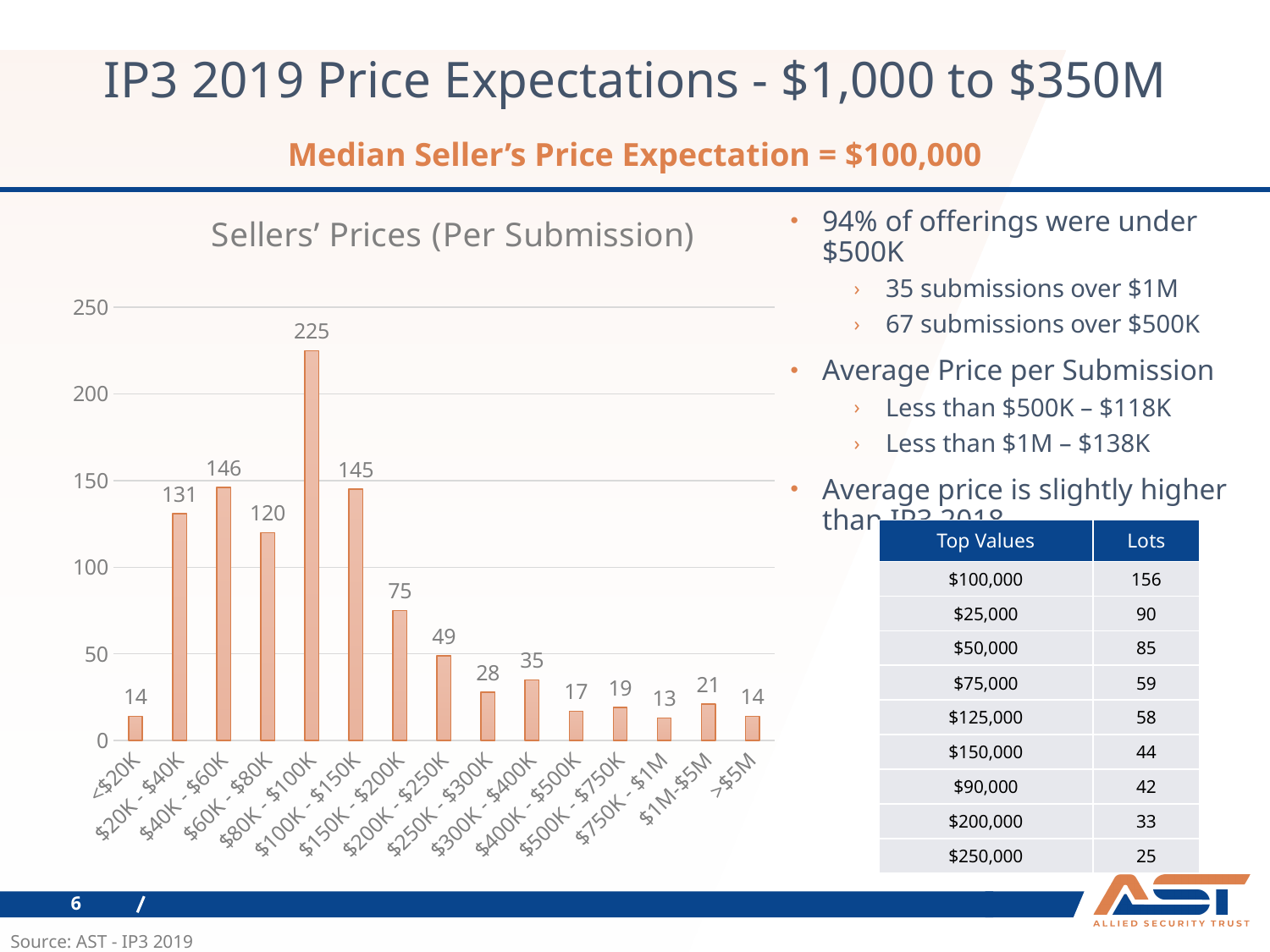
Which category has the lowest value in the Sellers' Prices (Per Submission) chart? $750K - $1M What is the difference between the values for $80K - $100K and $60K - $80K in the Sellers' Prices (Per Submission) chart? 105 What kind of chart is the Sellers' Prices (Per Submission) chart? bar chart What is the value for the $200K - $250K category in the Sellers' Prices (Per Submission) chart? 49 What is the value for the $80K - $100K category in the Sellers' Prices (Per Submission) chart? 225 How many categories are shown on the x axis of the Sellers' Prices (Per Submission) chart? 15 Which category has the highest value in the Sellers' Prices (Per Submission) chart? $80K - $100K What is the value for the $20K - $40K category in the Sellers' Prices (Per Submission) chart? 131 What is the title of the chart on the slide? Sellers' Prices (Per Submission) Which is larger in the Sellers' Prices (Per Submission) chart, the value for $150K - $200K or the value for $300K - $400K? $150K - $200K What is the difference between the values for $40K - $60K and $100K - $150K in the Sellers' Prices (Per Submission) chart? 1 Is the value for $250K - $300K greater or less than 50 in the Sellers' Prices (Per Submission) chart? less